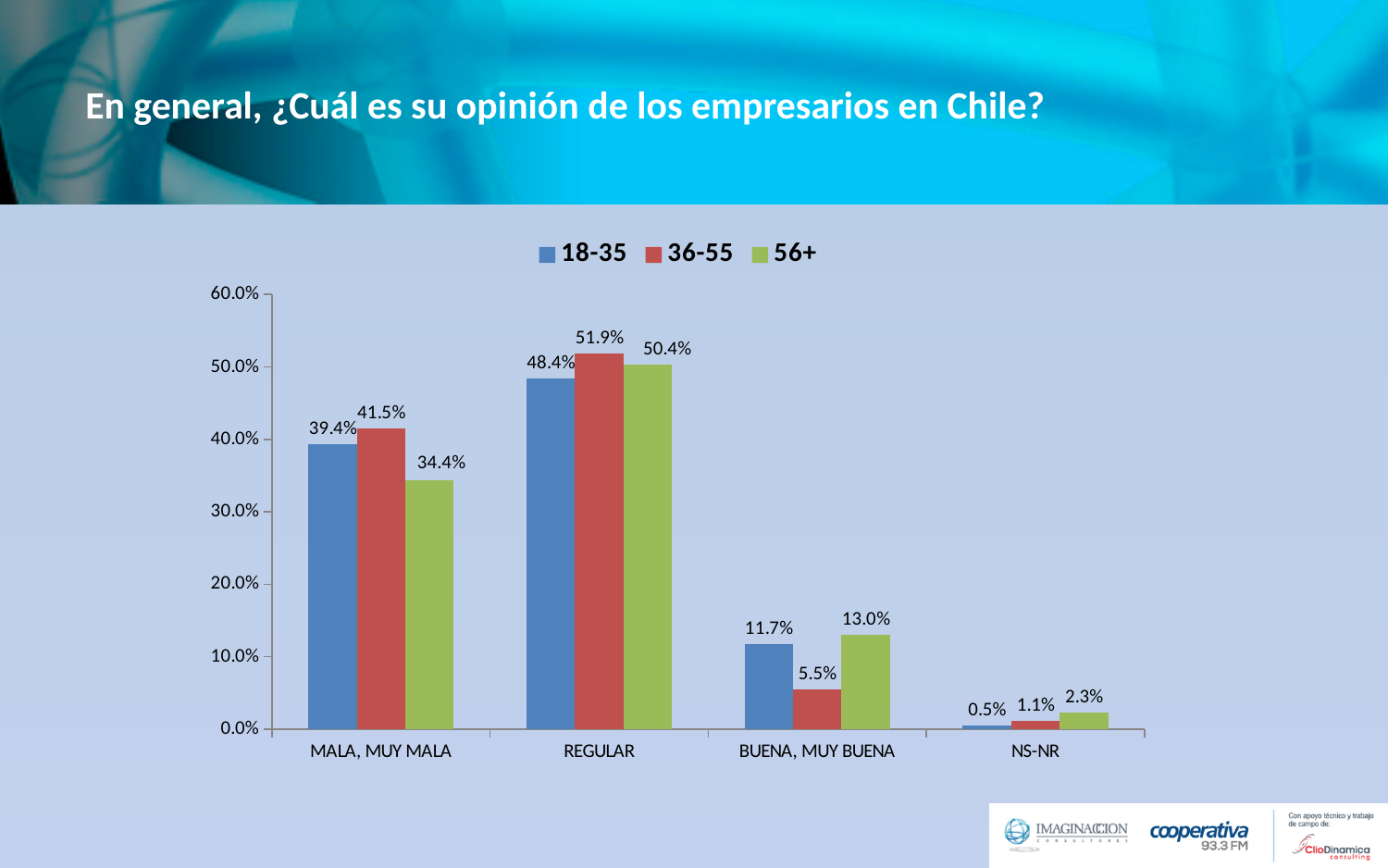
Which series is shown in green in the legend? 56+ In the BUENA, MUY BUENA category, which series has the larger value: 18-35 or 36-55? 18-35 Which category has the lowest value for the 56+ series? NS-NR How many series does the legend list? 3 What kind of chart is shown on the slide? bar chart How many categories are shown on the x axis? 4 Is the value for the 56+ series in the REGULAR category greater or less than 40.0%? greater Which category has the highest value for the 18-35 series? REGULAR What is the value for the 36-55 series in the REGULAR category? 51.9% What is the difference between the 36-55 and 18-35 values in the MALA, MUY MALA category? 2.1% What is the value for the 18-35 series in the BUENA, MUY BUENA category? 11.7% What is the value for the 56+ series in the MALA, MUY MALA category? 34.4%